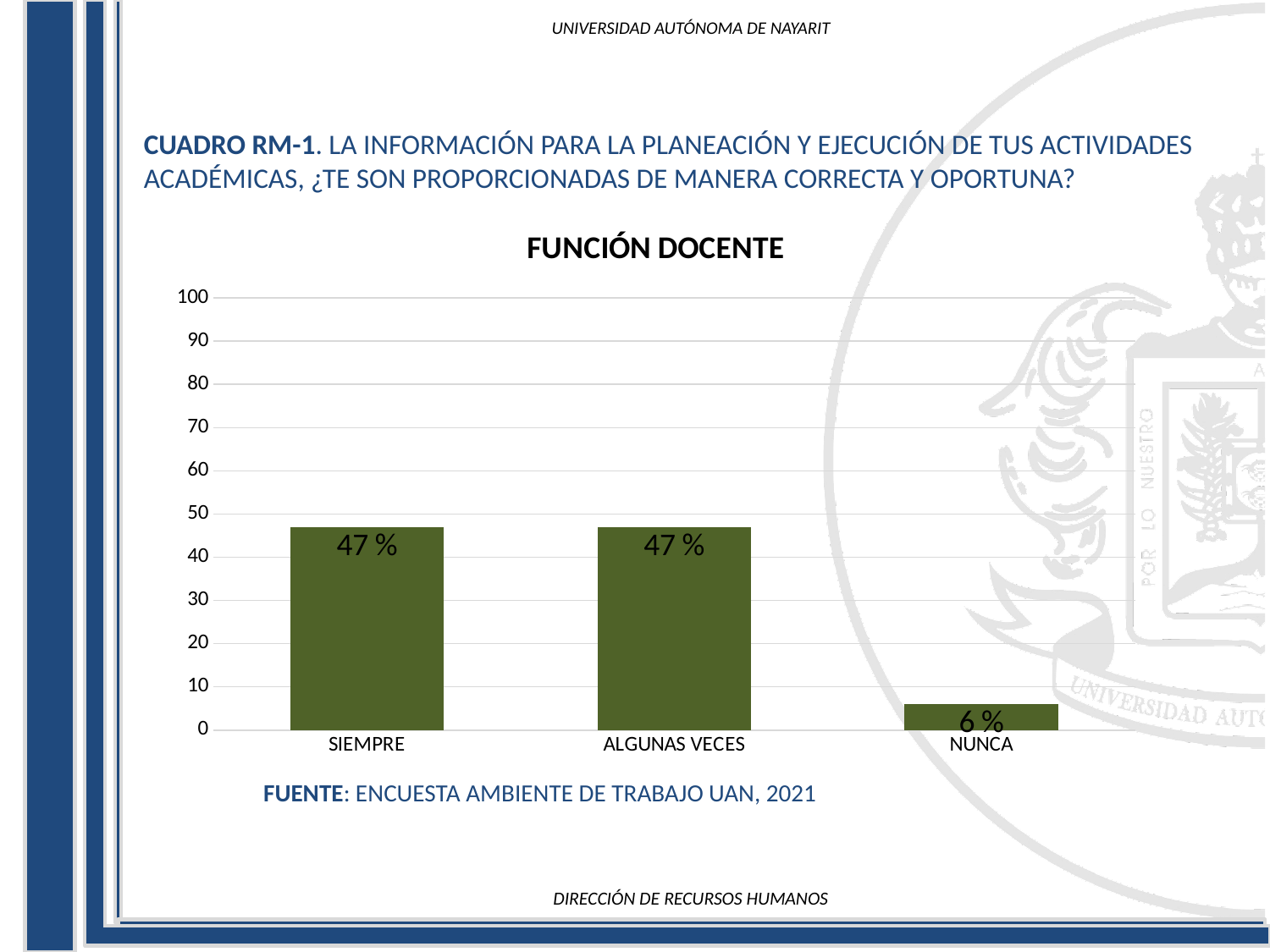
What is the value for ALGUNAS VECES? 47 % What is the difference between the values for SIEMPRE and NUNCA? 41 % How many categories are shown on the x axis? 3 Is the value for SIEMPRE greater or less than 50? less What is the title of the chart? FUNCIÓN DOCENTE Is the value for NUNCA greater or less than 10? less Which category has the lowest value? NUNCA Which is larger, the value for ALGUNAS VECES or the value for NUNCA? ALGUNAS VECES What is the value for NUNCA? 6 % What is the value for SIEMPRE? 47 % What kind of chart is shown on the slide? bar chart What is the highest value shown on the y axis? 100